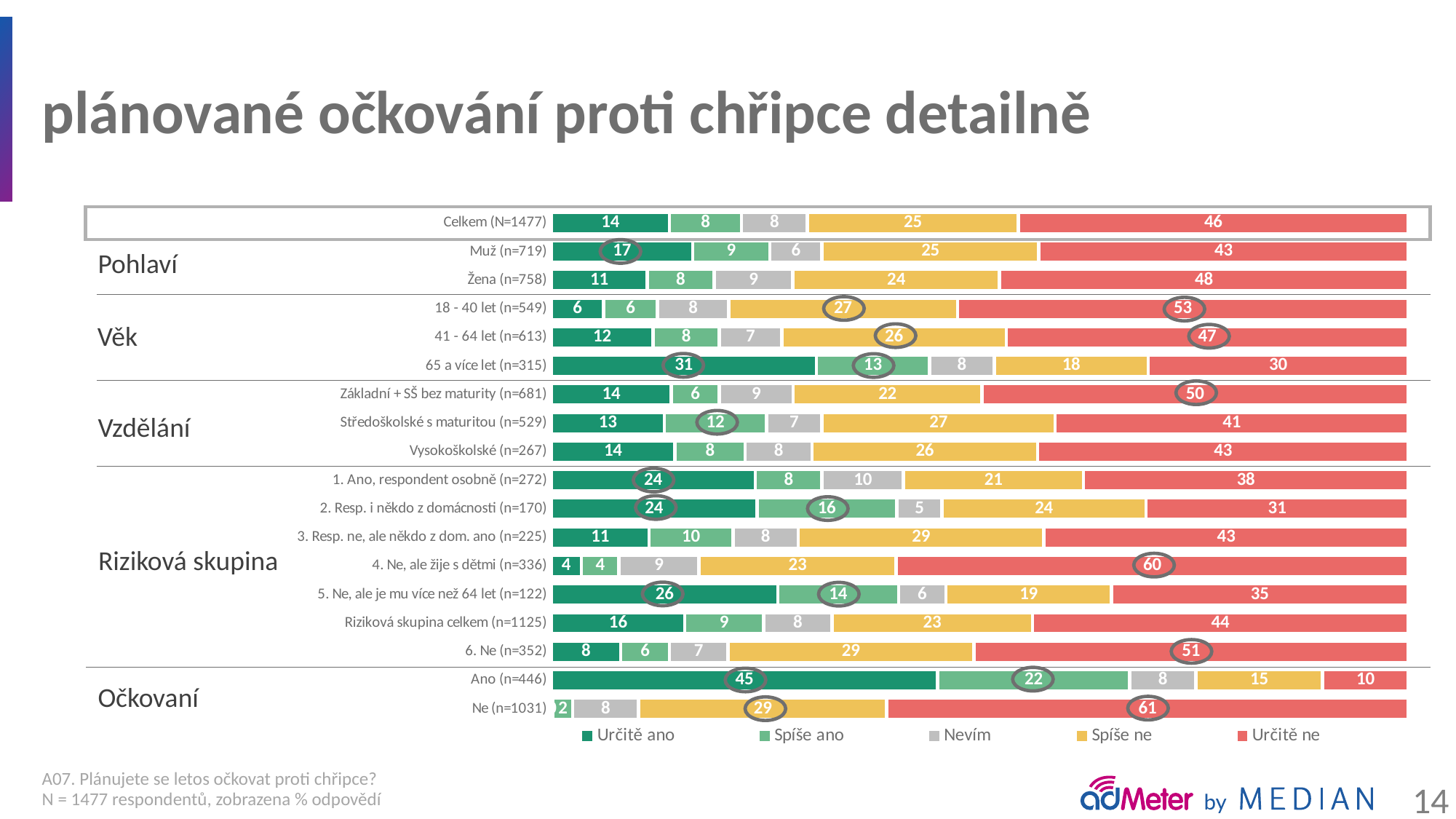
What is the difference between the 'Určitě ano' values for 'Muž (n=719)' and 'Žena (n=758)'? 6 What kind of chart is shown on the slide? Stacked bar chart Which category has the highest value for 'Určitě ano'? Ano (n=446) How many series does the legend list? 5 What is the total of the stacked bar for 'Ano (n=446)'? 100 How many bars (categories) are plotted in the chart? 18 Which category has the lowest value for 'Určitě ne'? Ano (n=446) What colour represents 'Nevím' in the legend? Grey What is the value of 'Určitě ne' for 'Celkem (N=1477)'? 46 What is the value of 'Určitě ano' for '65 a více let (n=315)'? 31 Which has the larger 'Spíše ne' value: '18 - 40 let (n=549)' or '65 a více let (n=315)'? 18 - 40 let (n=549) What is the value of 'Nevím' for '1. Ano, respondent osobně (n=272)'? 10